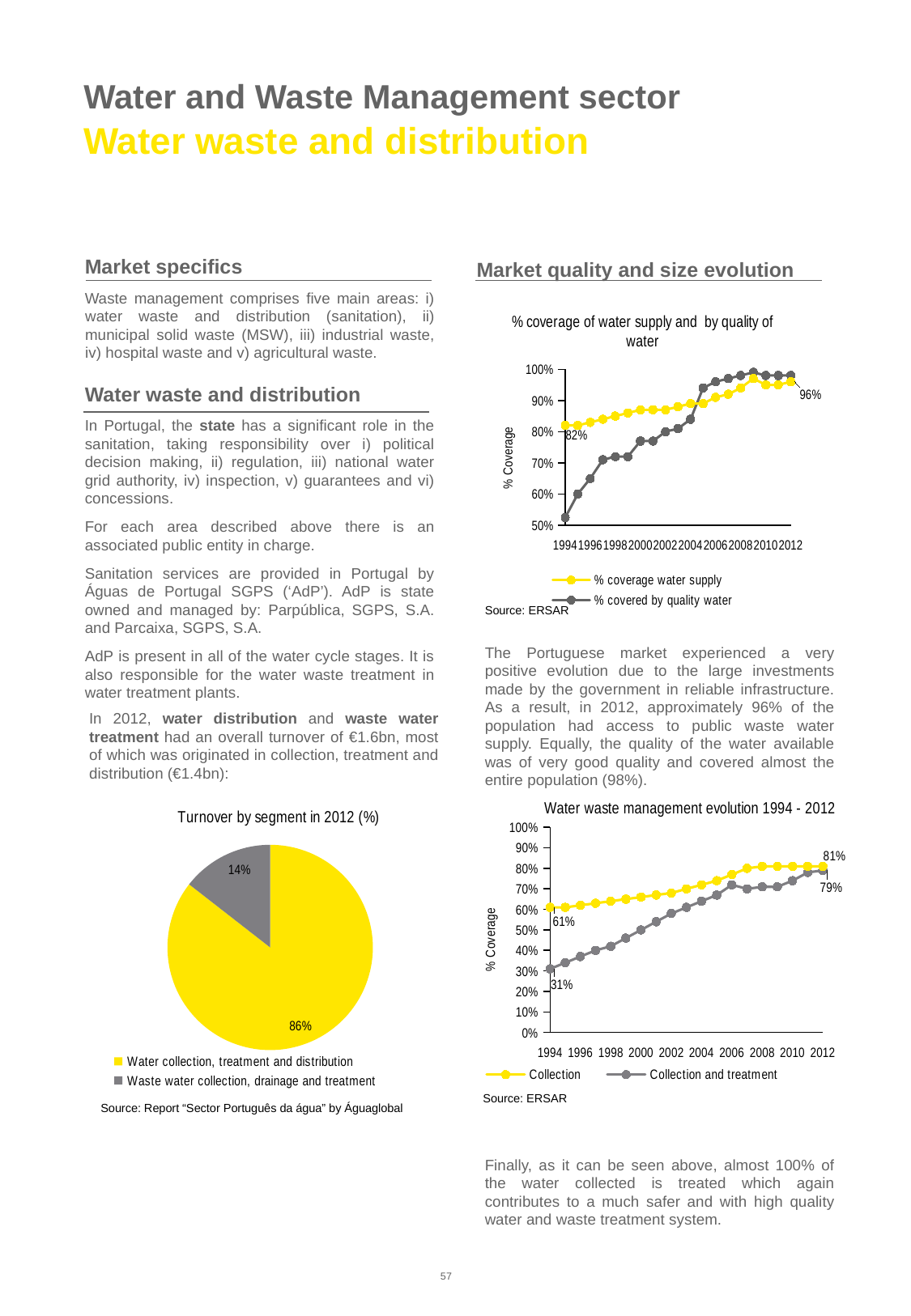
In the 'Turnover by segment in 2012 (%)' chart, what share does Waste water collection, drainage and treatment have? 14% In the 'Water waste management evolution 1994 - 2012' chart, what is the Collection and treatment value in 2012? 79% In the '% coverage of water supply and by quality of water' chart, how many series does the legend list? 2 In the '% coverage of water supply and by quality of water' chart, what is the % coverage water supply value in 1994? 82% In the 'Water waste management evolution 1994 - 2012' chart, what is the Collection value in 1994? 61% What kind of chart is 'Turnover by segment in 2012 (%)'? Pie chart In the '% coverage of water supply and by quality of water' chart, is the % covered by quality water value in 1994 greater or less than 60%? less In the 'Turnover by segment in 2012 (%)' chart, which segment is the largest? Water collection, treatment and distribution In the 'Turnover by segment in 2012 (%)' chart, what share does Water collection, treatment and distribution have? 86% In the '% coverage of water supply and by quality of water' chart, what is the % coverage water supply value in 2012? 96% In the 'Water waste management evolution 1994 - 2012' chart, does the Collection and treatment series rise or fall from 1994 to 2012? Rise In the 'Water waste management evolution 1994 - 2012' chart, what is the difference between the Collection and treatment values in 2012 and 1994? 48%